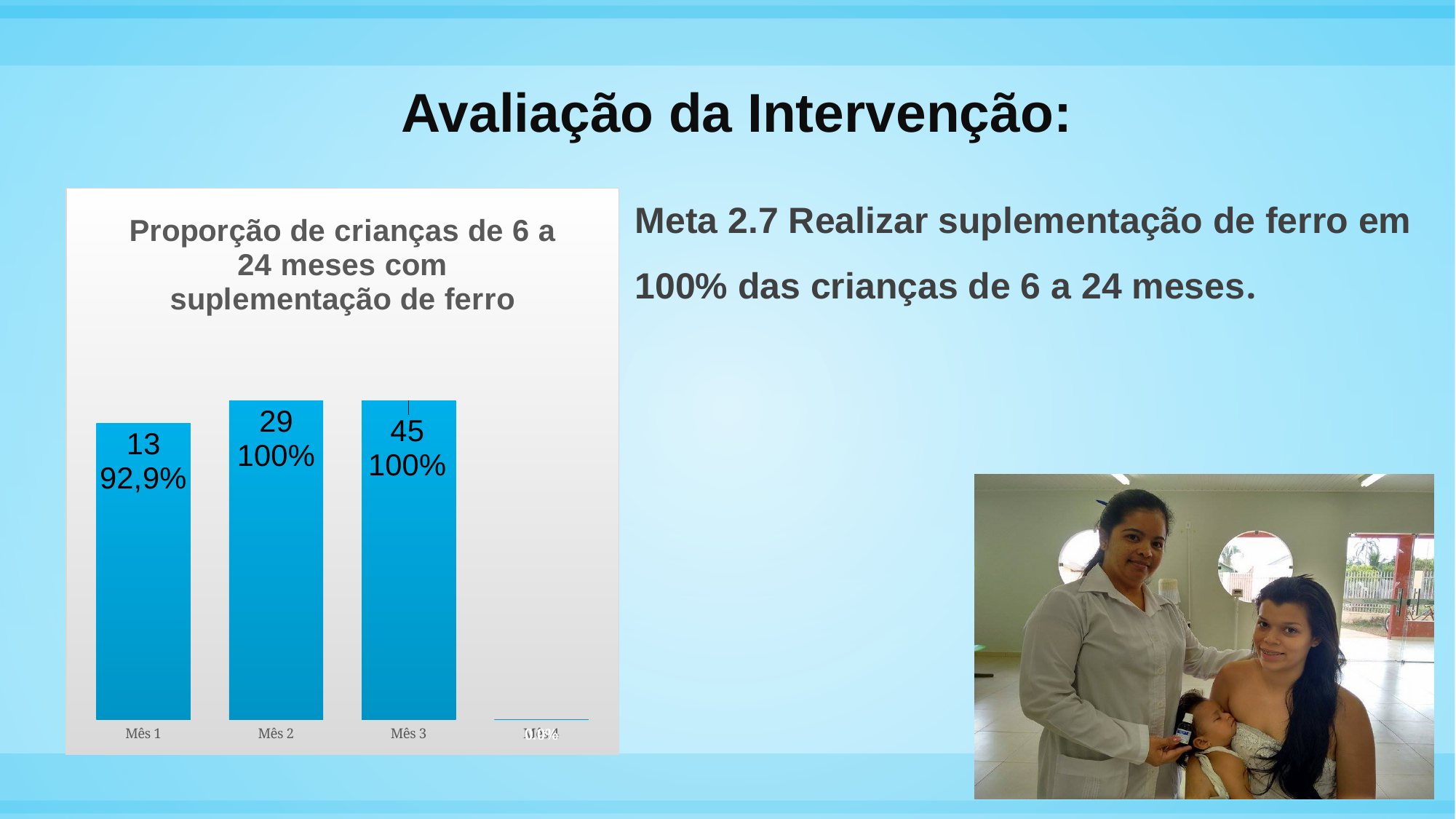
How many children are shown for Mês 3? 45 Does the number of children rise or fall from Mês 1 to Mês 3? Rise What is the difference between the number of children in Mês 2 and Mês 1? 16 What percentage is shown for Mês 1? 92,9% How many children are shown for Mês 2? 29 How many month categories are shown on the x axis? 4 Which has the higher percentage, Mês 1 or Mês 2? Mês 2 Among Mês 1, Mês 2 and Mês 3, which month has the lowest percentage? Mês 1 What is the difference between the number of children in Mês 3 and Mês 2? 16 What kind of chart is shown on the slide? Bar chart What percentage is shown for Mês 3? 100% What is the title of the chart? Proporção de crianças de 6 a 24 meses com suplementação de ferro